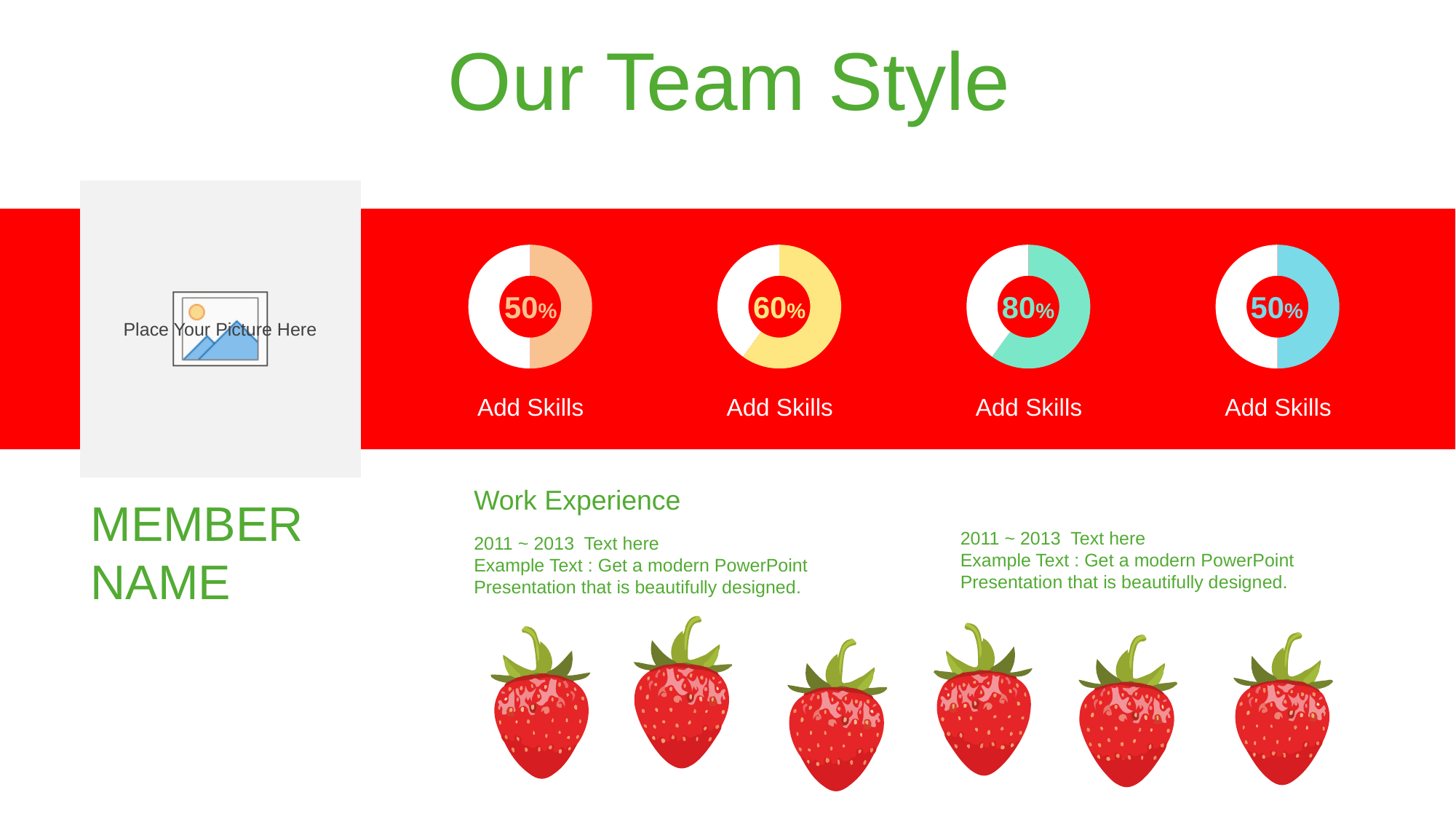
What percentage is shown in the leftmost donut chart on the red band? 50% Which is larger: the percentage in the second donut chart or the percentage in the rightmost donut chart? The second donut chart (60%) What colour is the filled portion of the third donut chart from the left? Teal (mint green) What kind of charts are used to display the skill percentages? Donut charts What is the difference between the percentage in the third donut chart and the percentage in the second donut chart? 20% What is the difference between the percentage in the third donut chart and the percentage in the leftmost donut chart? 30% Which donut chart shows the highest percentage? The third from the left (80%) What percentage is shown in the third donut chart from the left? 80% What percentage is shown in the second donut chart from the left? 60% What percentage is shown in the rightmost donut chart? 50% What label appears beneath each of the four donut charts? Add Skills How many donut charts are shown on the red band? 4